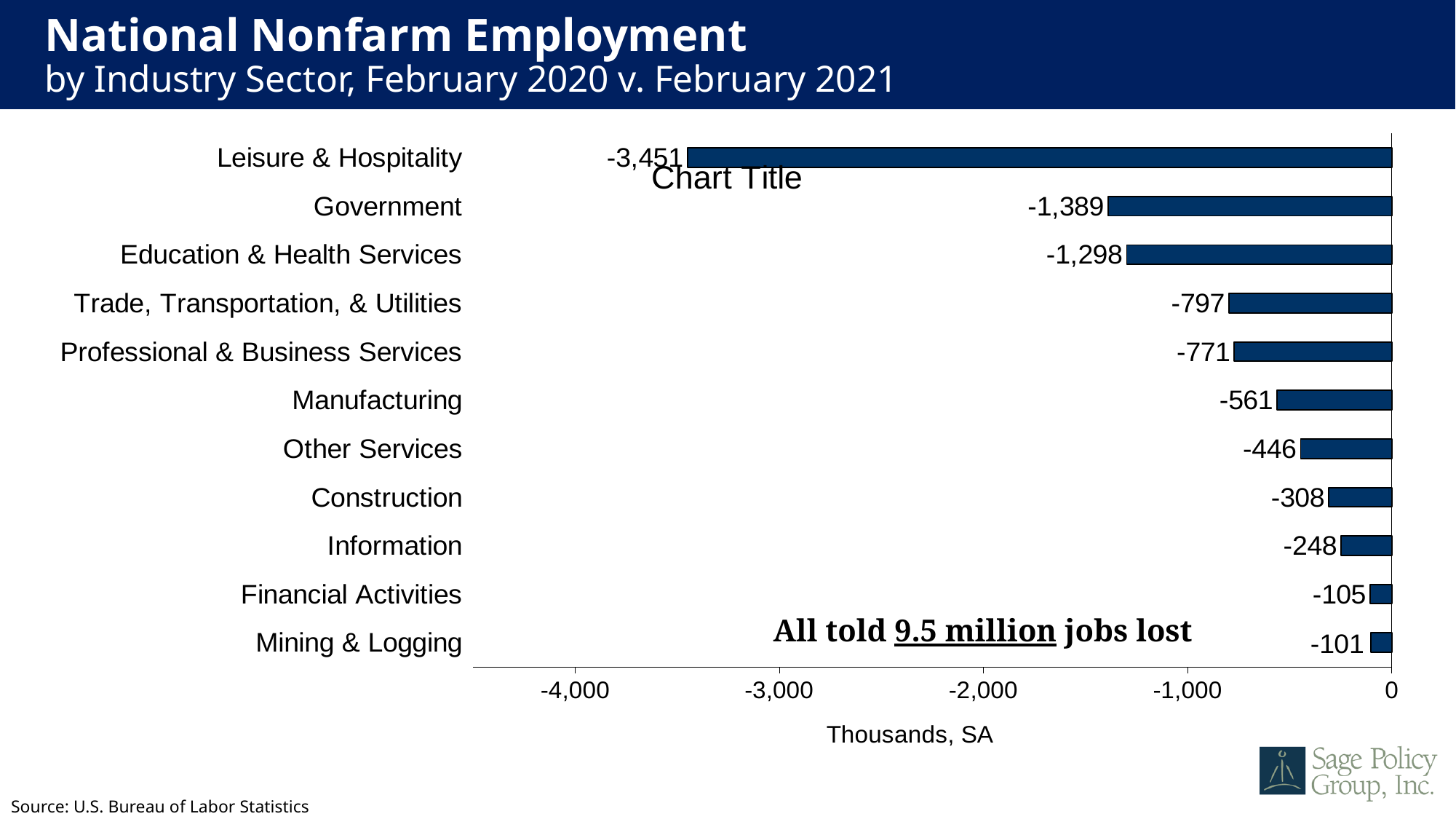
What is the value shown for Mining & Logging? -101 What is the value shown for Government? -1,389 What is the value shown for Education & Health Services? -1,298 Which sector lost more jobs, Trade, Transportation, & Utilities or Professional & Business Services? Trade, Transportation, & Utilities How many industry sectors are shown in the chart? 11 Which industry sector shows the smallest job loss? Mining & Logging What kind of chart is shown on the slide? Bar chart What is the difference between the values for Government and Education & Health Services? 91 What unit is given on the x-axis label of the chart? Thousands, SA What is the value shown for Manufacturing? -561 Which industry sector shows the largest job loss? Leisure & Hospitality What is the value shown for Leisure & Hospitality? -3,451